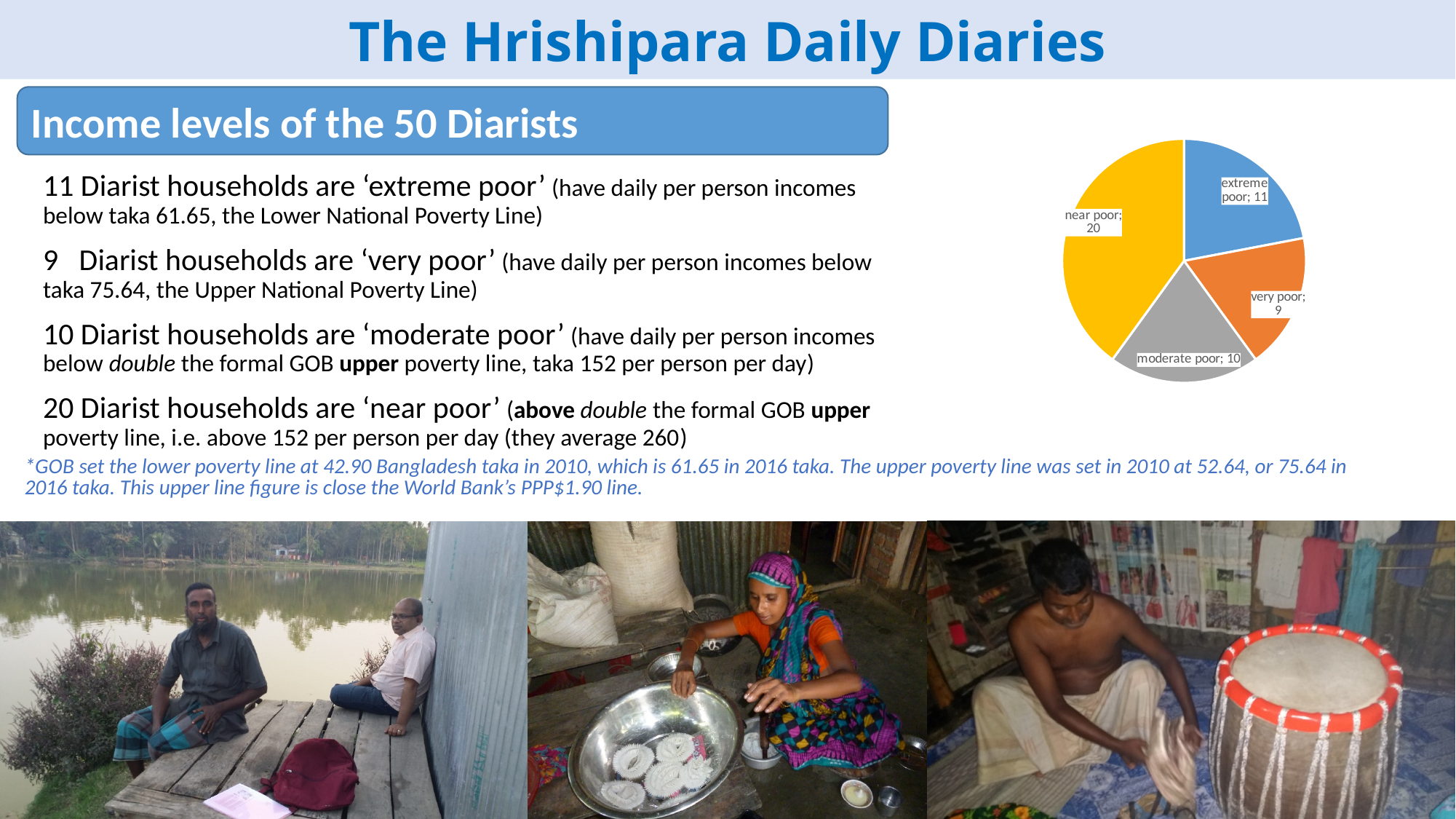
What colour is the 'near poor' slice in the pie chart? yellow What kind of chart is shown on the slide? pie chart How many slices does the pie chart have? 4 What is the value for 'moderate poor' in the pie chart? 10 What is the value for 'very poor' in the pie chart? 9 What is the value for 'near poor' in the pie chart? 20 What is the difference between the 'near poor' and 'extreme poor' values in the pie chart? 9 What share of the pie chart does the 'near poor' slice represent? 40% What is the value for 'extreme poor' in the pie chart? 11 Which is larger in the pie chart, 'extreme poor' or 'moderate poor'? extreme poor Which category has the largest slice in the pie chart? near poor Which category has the smallest slice in the pie chart? very poor